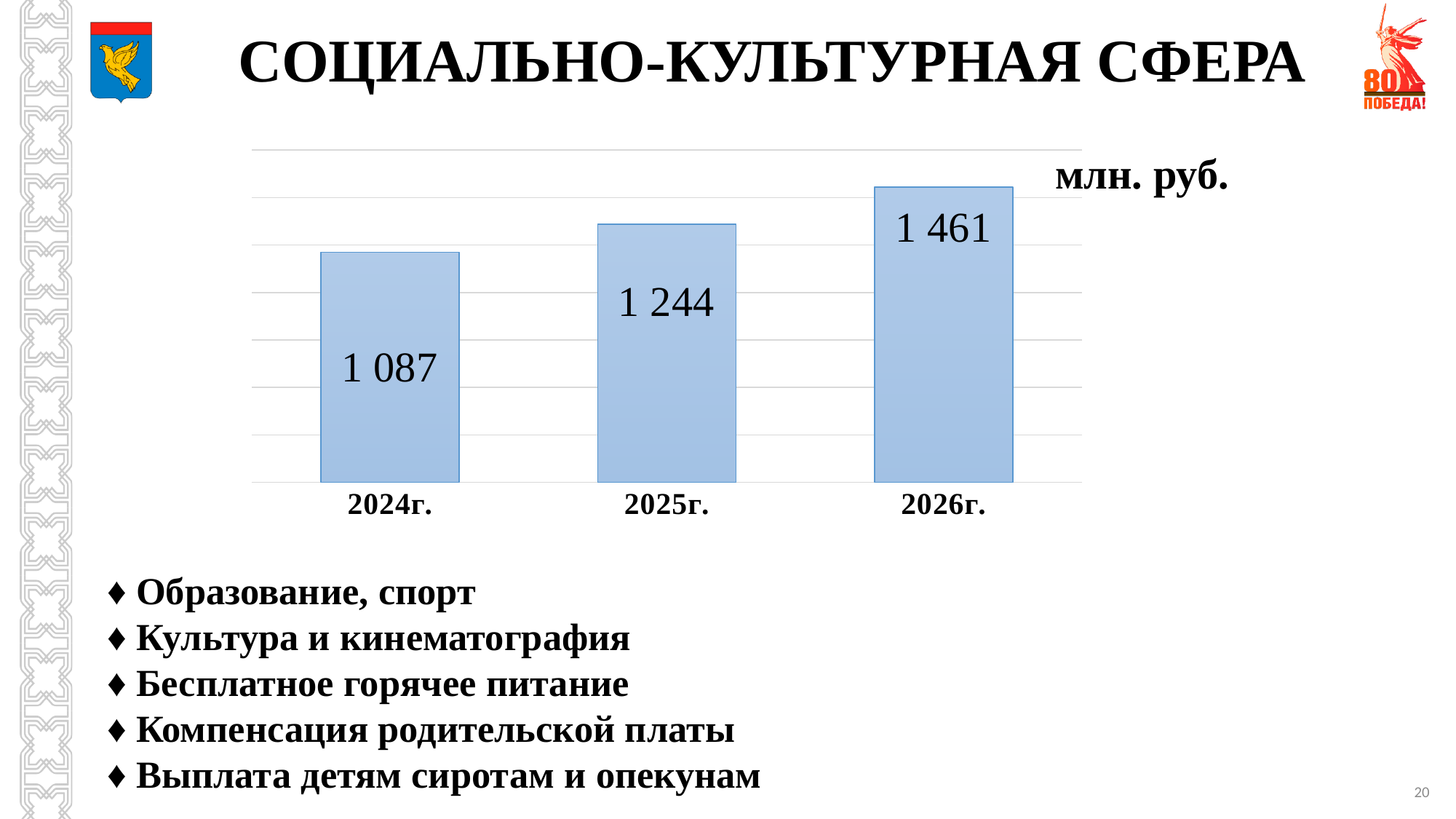
How many years are shown on the chart? 3 What is the value for 2024г.? 1 087 Which is larger, the value for 2025г. or the value for 2026г.? 2026г. What is the difference between the values for 2026г. and 2024г.? 374 What unit is indicated for the chart values? млн. руб. Which year has the highest value? 2026г. What is the value for 2026г.? 1 461 Do the values rise or fall from 2024г. to 2026г.? rise What is the difference between the values for 2025г. and 2024г.? 157 Which year has the lowest value? 2024г. What kind of chart is shown on the slide? bar chart What is the value for 2025г.? 1 244